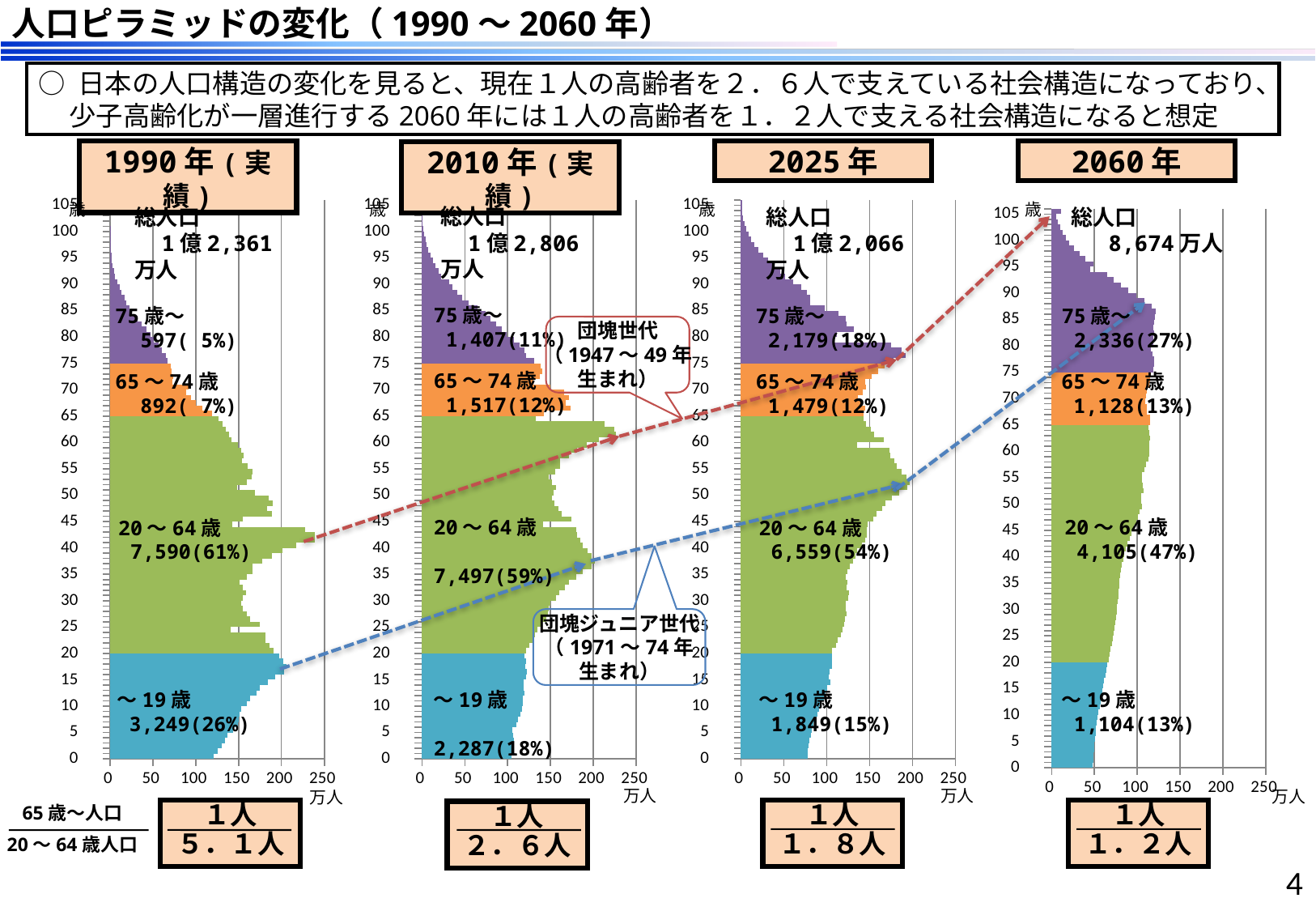
In the 2025年 chart, what is the total population (総人口) shown? 1億2,066万人 In the 1990年(実績) chart, which age group has the smallest population? 75歳～ In the 2010年(実績) chart, what percentage is shown for the 65～74歳 age group? 12% In the 1990年(実績) chart, what is the printed value for the 20～64歳 age group? 7,590(61%) Across the four charts from 1990 to 2060, does the ～19歳 population rise or fall? Fall In the 2060年 chart, what is the printed value for the 75歳～ age group? 2,336(27%) In the 2025年 chart, which is larger: the 75歳～ group or the 65～74歳 group? 75歳～ What kind of chart is used for each population pyramid on the slide? Bar chart How many age groups are labelled in each population pyramid chart? 4 In the 2010年(実績) chart, which age group has the largest population? 20～64歳 What unit is shown on the horizontal axis of the population pyramid charts? 万人 What is the difference between the 20～64歳 population in the 2010年(実績) chart (7,497) and in the 2060年 chart (4,105)? 3,392